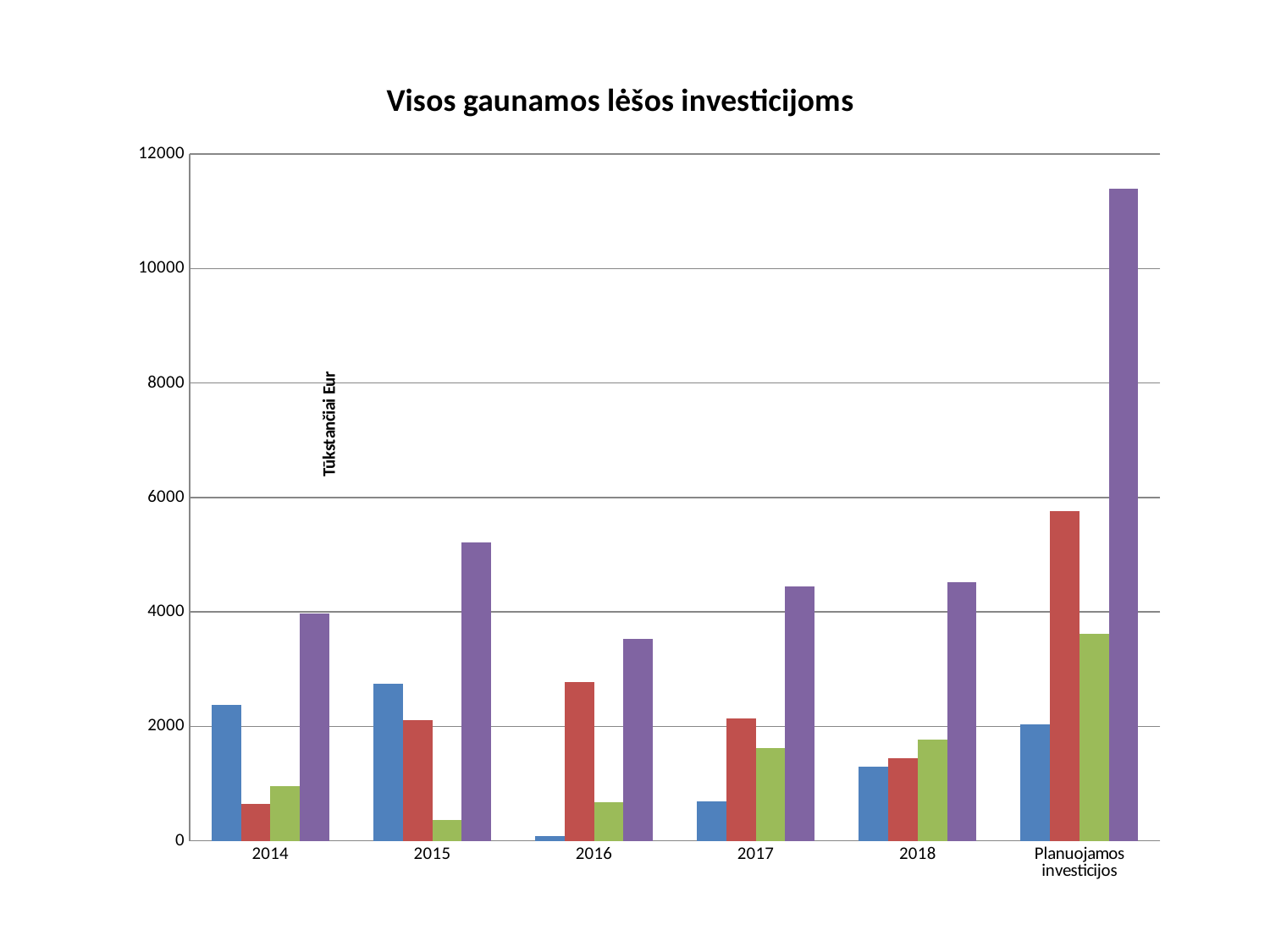
For which category is the purple bar the lowest? 2016 Is the value of the purple bar for Planuojamos investicijos greater or less than 10000? greater For which category is the blue bar the lowest? 2016 Which is larger: the purple bar for 2015 or the purple bar for 2017? 2015 Is the value of the red bar for Planuojamos investicijos greater or less than 6000? less For which category is the green bar the lowest? 2015 Is the value of the purple bar for 2015 greater or less than 4000? greater What is the title of the chart? Visos gaunamos lėšos investicijoms How many categories are shown along the x axis of the chart? 6 What is the label on the vertical axis of the chart? Tūkstančiai Eur What kind of chart is shown on the slide? Bar chart For which category is the purple bar the highest? Planuojamos investicijos